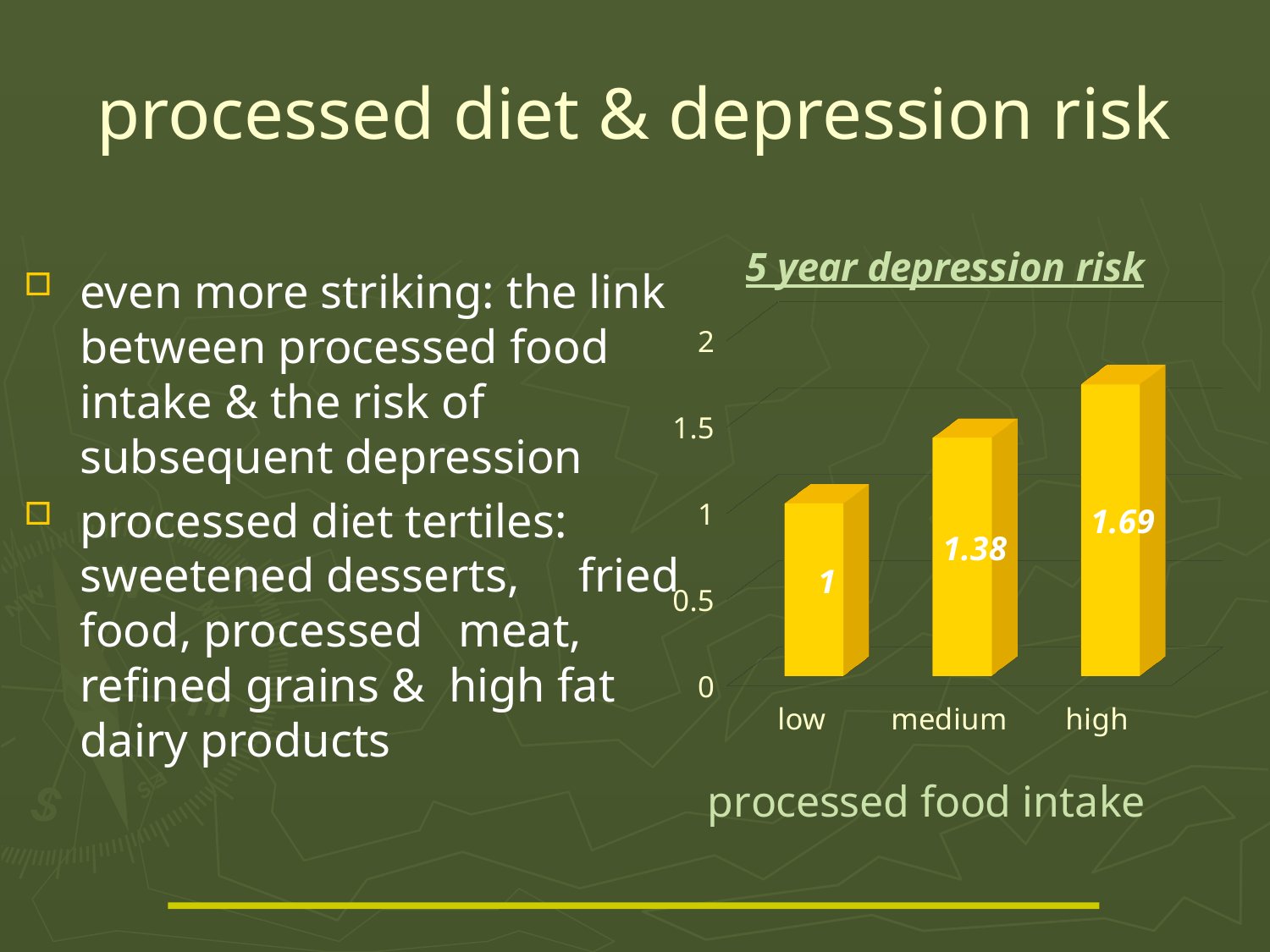
Which has a higher 5 year depression risk, the medium or the high intake group? high What is the difference in 5 year depression risk between the high and low intake groups? 0.69 What is the 5 year depression risk for the low processed food intake group? 1 What is the 5 year depression risk for the medium processed food intake group? 1.38 Does the 5 year depression risk rise or fall as processed food intake goes from low to high? rise Which processed food intake group has the highest 5 year depression risk? high Is the 5 year depression risk for the high intake group greater or less than 1.5? greater What is the 5 year depression risk for the high processed food intake group? 1.69 Which processed food intake group has the lowest 5 year depression risk? low How many processed food intake categories are shown in the chart? 3 What kind of chart is used to show 5 year depression risk? bar chart What is the difference in 5 year depression risk between the medium and low intake groups? 0.38